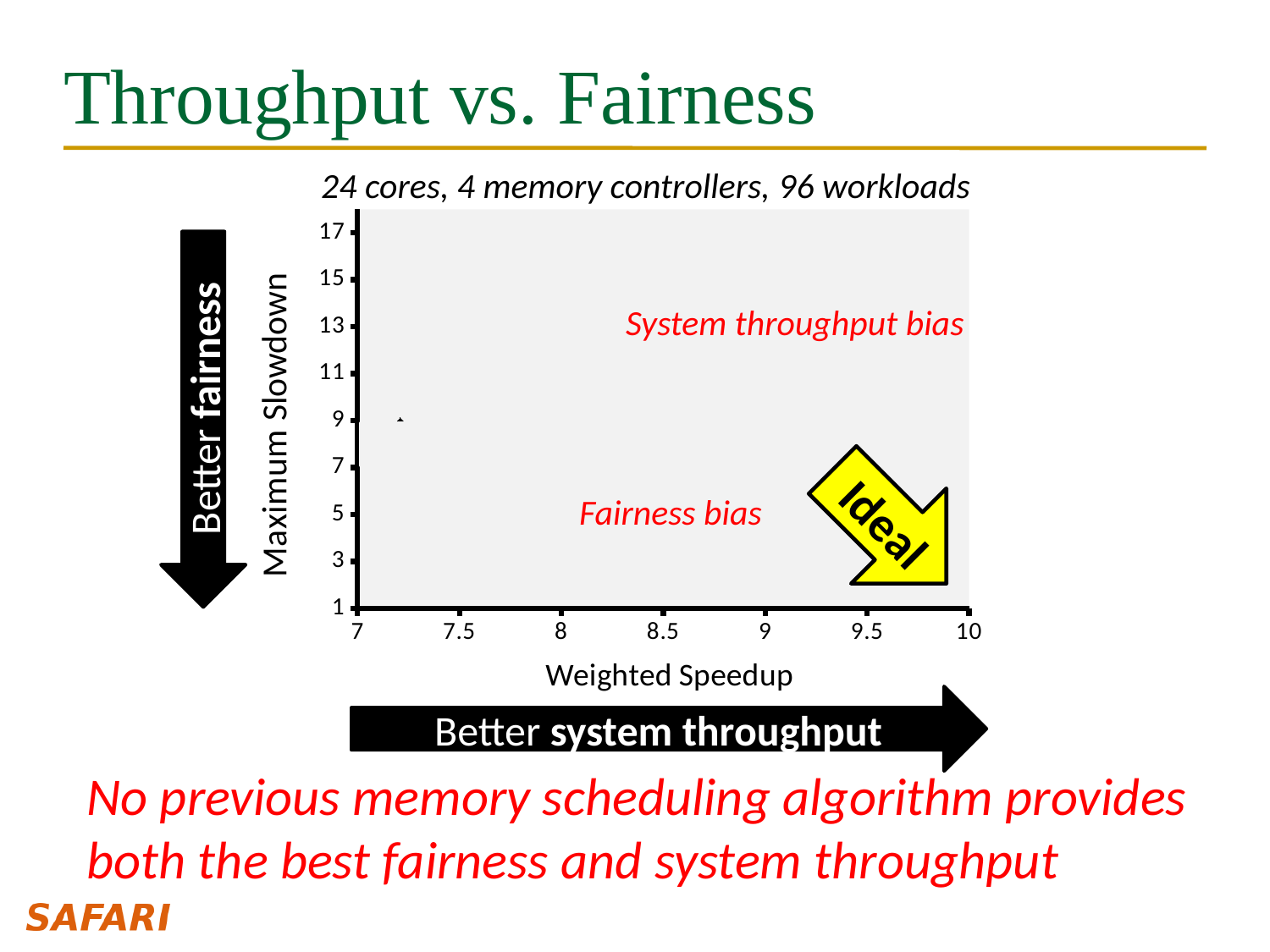
Is the Weighted Speedup of the plotted point greater or less than 8? less What text appears as the title directly above the chart? 24 cores, 4 memory controllers, 96 workloads What is the label of the x axis of the chart? Weighted Speedup What kind of chart is shown on the slide? scatter chart Is the Weighted Speedup of the plotted point greater or less than 9? less Is the Maximum Slowdown of the plotted point greater or less than 11? less How many data points are plotted on the chart? 1